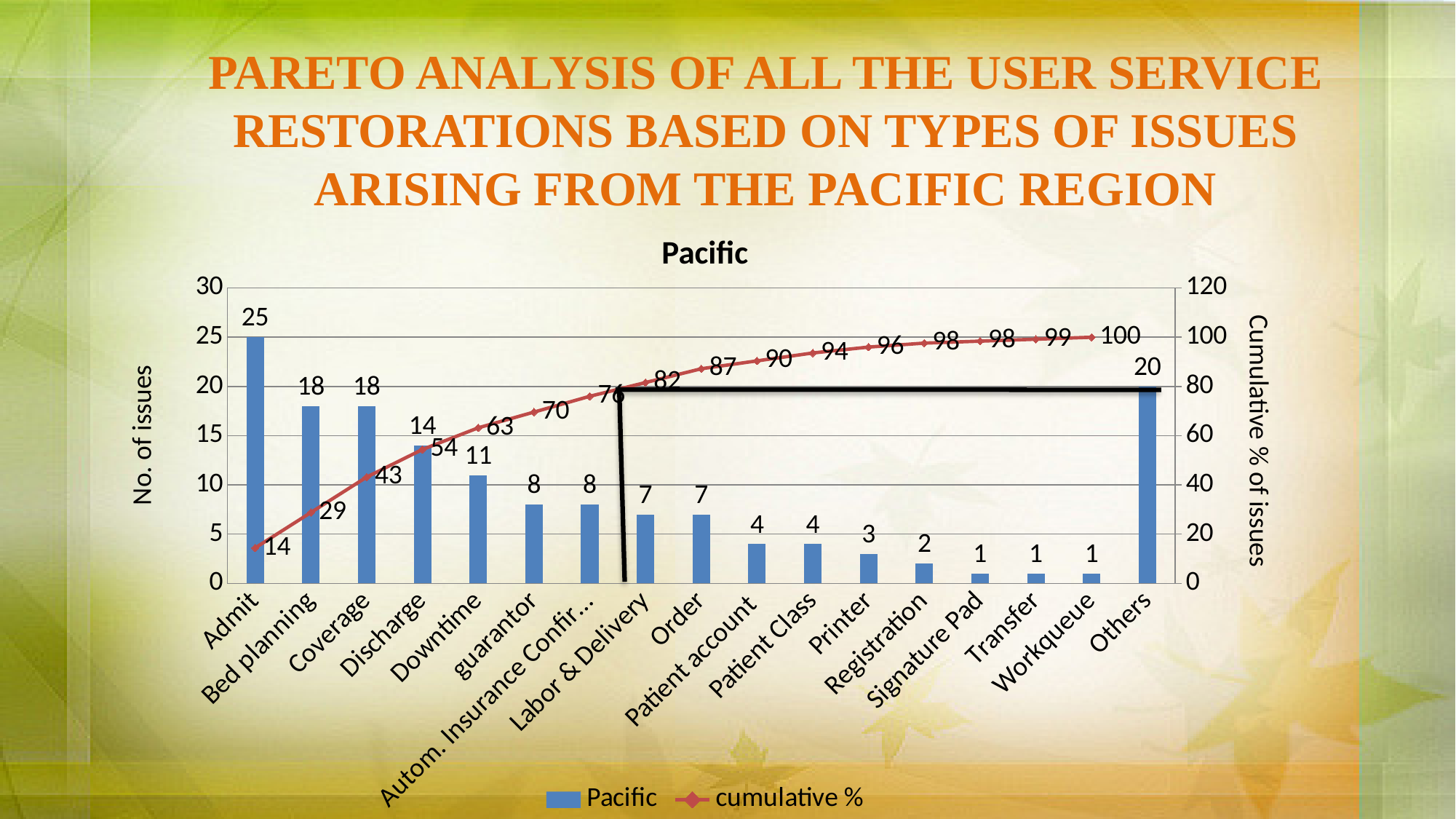
What is the number of issues for Admit? 25 What is the number of issues for Discharge? 14 How many categories are shown on the x axis? 17 What is the cumulative % value at Downtime? 63 How many series does the legend list? 2 What kind of chart is this? Combined bar and line chart (Pareto chart) Which category has the highest number of issues? Admit What is the difference in number of issues between Admit and Downtime? 14 Which has more issues, Printer or Registration? Printer What is the title of the chart? Pacific Does the cumulative % line rise or fall from Admit to Workqueue? Rise What is the number of issues for Others? 20